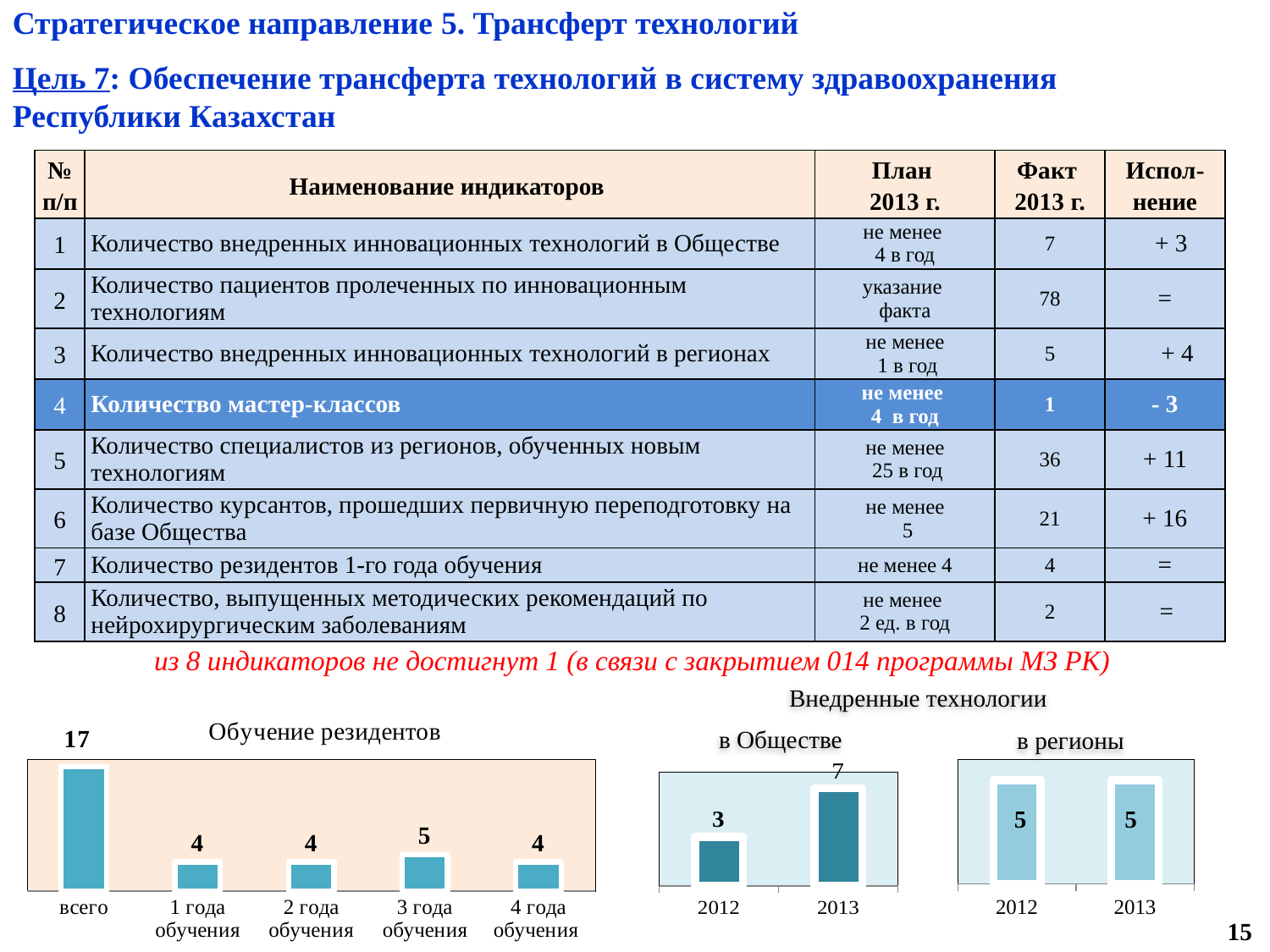
In the 'Внедренные технологии в Обществе' chart, do the values rise or fall from 2012 to 2013? rise In the 'Обучение резидентов' chart, which category has the highest value? всего In the 'Внедренные технологии в Обществе' chart, what is the value for 2013? 7 In the 'Внедренные технологии в Обществе' chart, what is the difference between 2013 and 2012? 4 In the 'Обучение резидентов' chart, what is the value for '3 года обучения'? 5 In the 'Обучение резидентов' chart, what is the difference between 'всего' and '3 года обучения'? 12 In the 'Обучение резидентов' chart, what is the value for 'всего'? 17 In the 'Внедренные технологии в регионы' chart, what is the value for 2013? 5 In the 'Внедренные технологии в Обществе' chart, what is the value for 2012? 3 In the 'Внедренные технологии в регионы' chart, is the value for 2012 larger than, smaller than, or equal to the value for 2013? equal In the 'Обучение резидентов' chart, how many categories are shown on the x axis? 5 What type of chart is 'Обучение резидентов'? bar chart